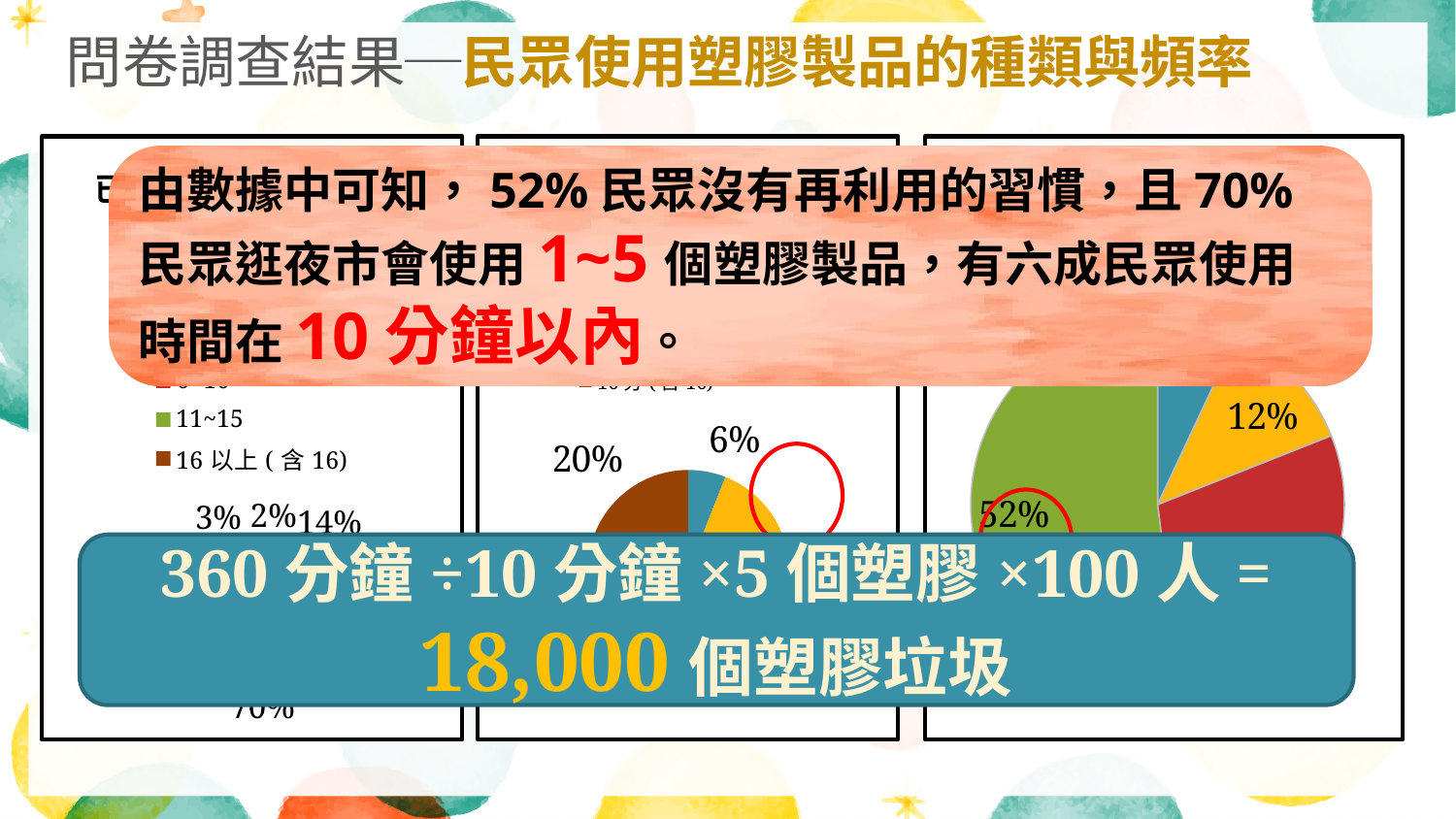
What kind of chart is the left chart on the slide? pie chart In the right chart, what is the difference between the 52% slice and the 12% slice? 40 percentage points How many charts are shown on the slide? 3 In the right chart, what is the value labelled on the yellow slice? 12% In the left chart, which legend entry is shown in brown? 16 以上 ( 含 16) In the middle chart, what is the difference between the slice labelled 20% and the slice labelled 6%? 14 percentage points What kind of chart is the right chart on the slide? pie chart In the left chart, which legend entry is shown in green? 11~15 In the middle chart, which is larger, the slice labelled 20% or the slice labelled 6%? 20% In the left chart, what is the smallest percentage label shown? 2% In the right chart, what is the value of the largest slice? 52% In the right chart, which is larger, the slice labelled 52% or the slice labelled 12%? 52%